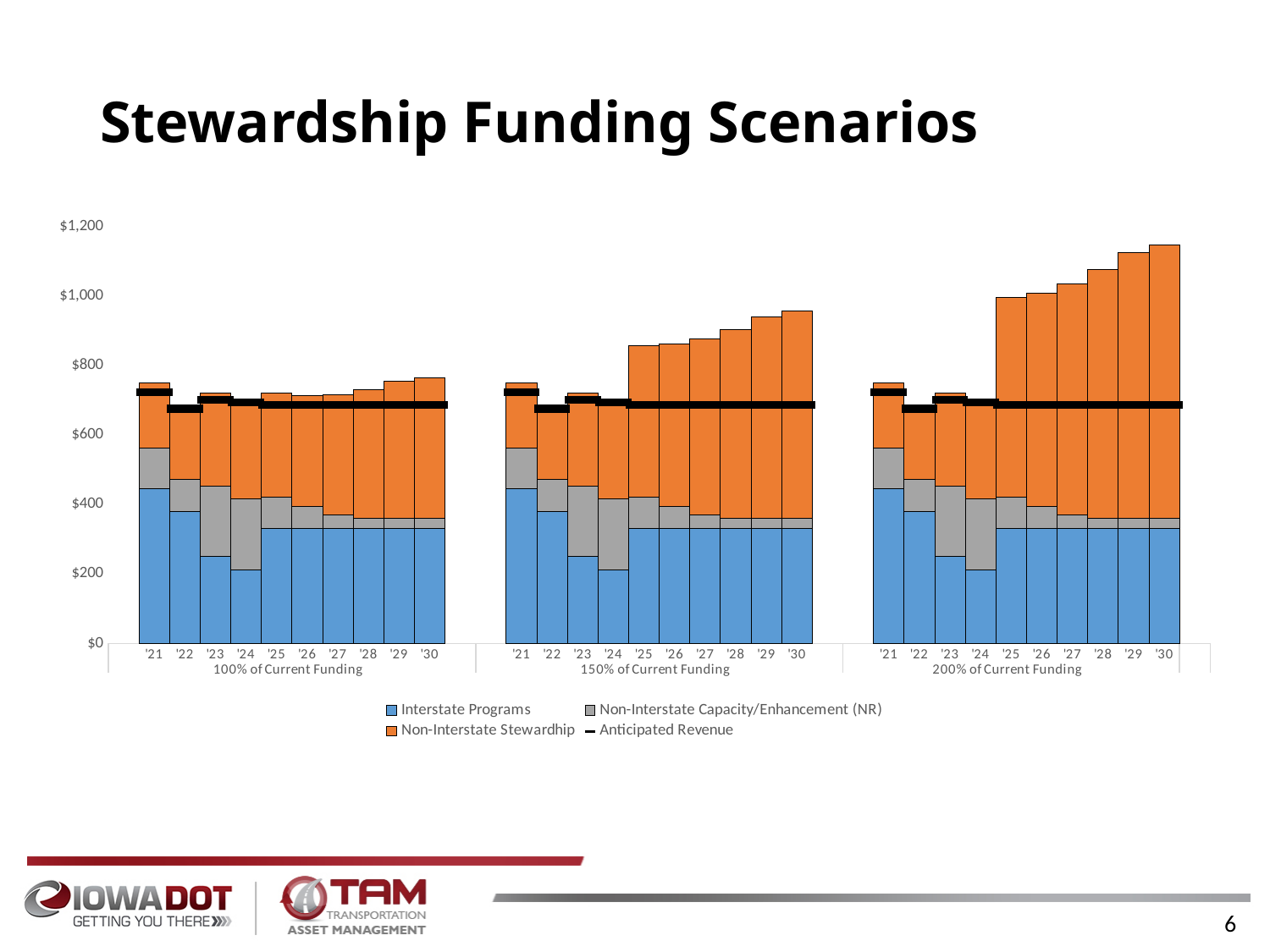
Is the total stacked value for '30 in the 100% of Current Funding group greater or less than $800? less How many series does the legend list? 4 In the 200% of Current Funding group, which year has the tallest stacked bar? '30 Which is larger: the total stacked bar for '30 in the 200% of Current Funding group or the total stacked bar for '30 in the 150% of Current Funding group? 200% of Current Funding Is the Interstate Programs value for '24 in the 100% of Current Funding group greater or less than $400? less What kind of chart is shown on the slide? bar chart How many years are plotted in each funding scenario group? 10 Is the total stacked value for '30 in the 200% of Current Funding group greater or less than $1,000? greater In the 200% of Current Funding group, do the total stacked bars rise or fall from '25 to '30? rise In the 100% of Current Funding group, which year has the lowest Interstate Programs value? '24 How many funding scenario groups are shown on the x axis? 3